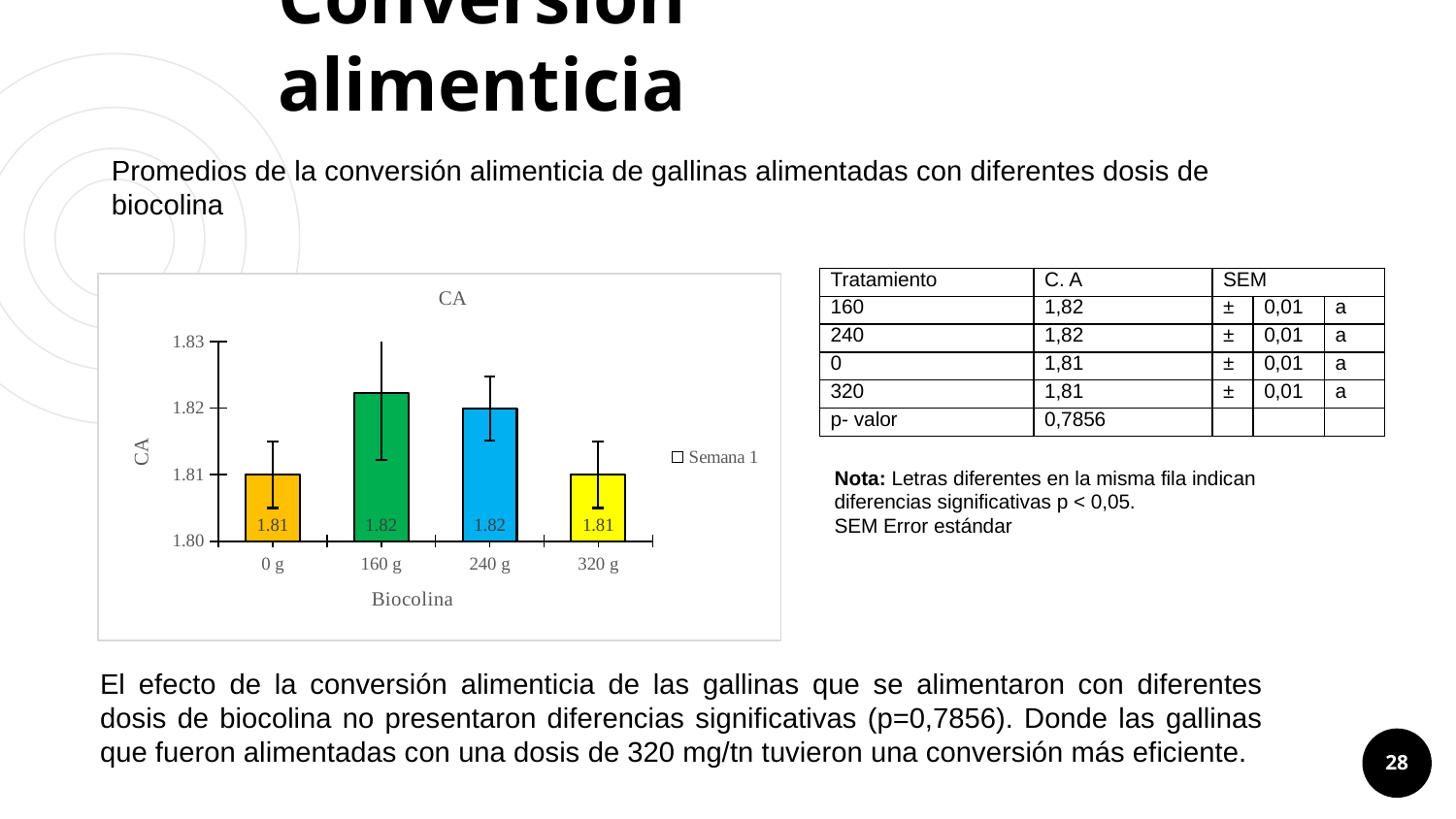
What series name appears in the chart legend? Semana 1 What type of chart is shown on the slide? bar chart Is the CA value for 240 g of Biocolina greater or less than 1.81? greater Which has a higher CA value, 0 g or 160 g of Biocolina? 160 g What is the CA value for 240 g of Biocolina? 1.82 What is the CA value for 320 g of Biocolina? 1.81 What is the CA value for 160 g of Biocolina? 1.82 What is the difference between the CA values for 240 g and 320 g of Biocolina? 0.01 What is the CA value for 0 g of Biocolina? 1.81 How many series does the chart legend list? 1 What is the title of the chart? CA How many Biocolina dose categories are shown on the x axis of the chart? 4